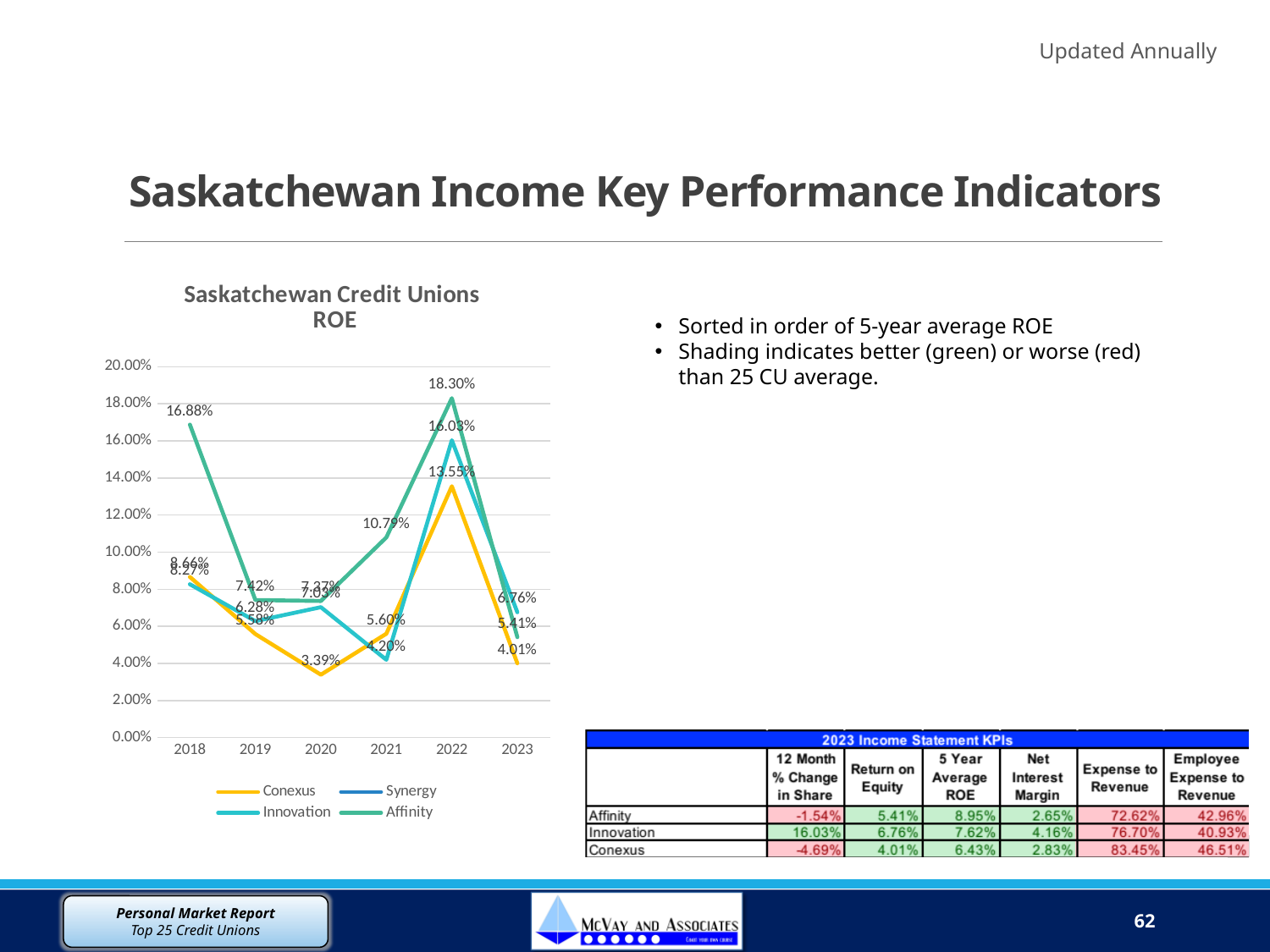
In the Saskatchewan Credit Unions ROE chart, what was Innovation's ROE in 2022? 16.03% In the Saskatchewan Credit Unions ROE chart, what was Affinity's ROE in 2022? 18.30% In the Saskatchewan Credit Unions ROE chart, in which year did Conexus have its lowest ROE? 2020 In the Saskatchewan Credit Unions ROE chart, is Affinity's ROE in 2021 greater or less than 10.00%? greater In the Saskatchewan Credit Unions ROE chart, what was Affinity's ROE in 2018? 16.88% How many series does the legend of the Saskatchewan Credit Unions ROE chart list? 4 In the Saskatchewan Credit Unions ROE chart, what was Conexus's ROE in 2023? 4.01% In the Saskatchewan Credit Unions ROE chart, what is the difference between Affinity's and Innovation's ROE in 2022? 2.27 percentage points In the Saskatchewan Credit Unions ROE chart, in which year did Affinity have its highest ROE? 2022 In the Saskatchewan Credit Unions ROE chart, which had the higher ROE in 2023, Innovation or Conexus? Innovation In the Saskatchewan Credit Unions ROE chart, what was Conexus's ROE in 2020? 3.39% What kind of chart is the Saskatchewan Credit Unions ROE chart? Line chart